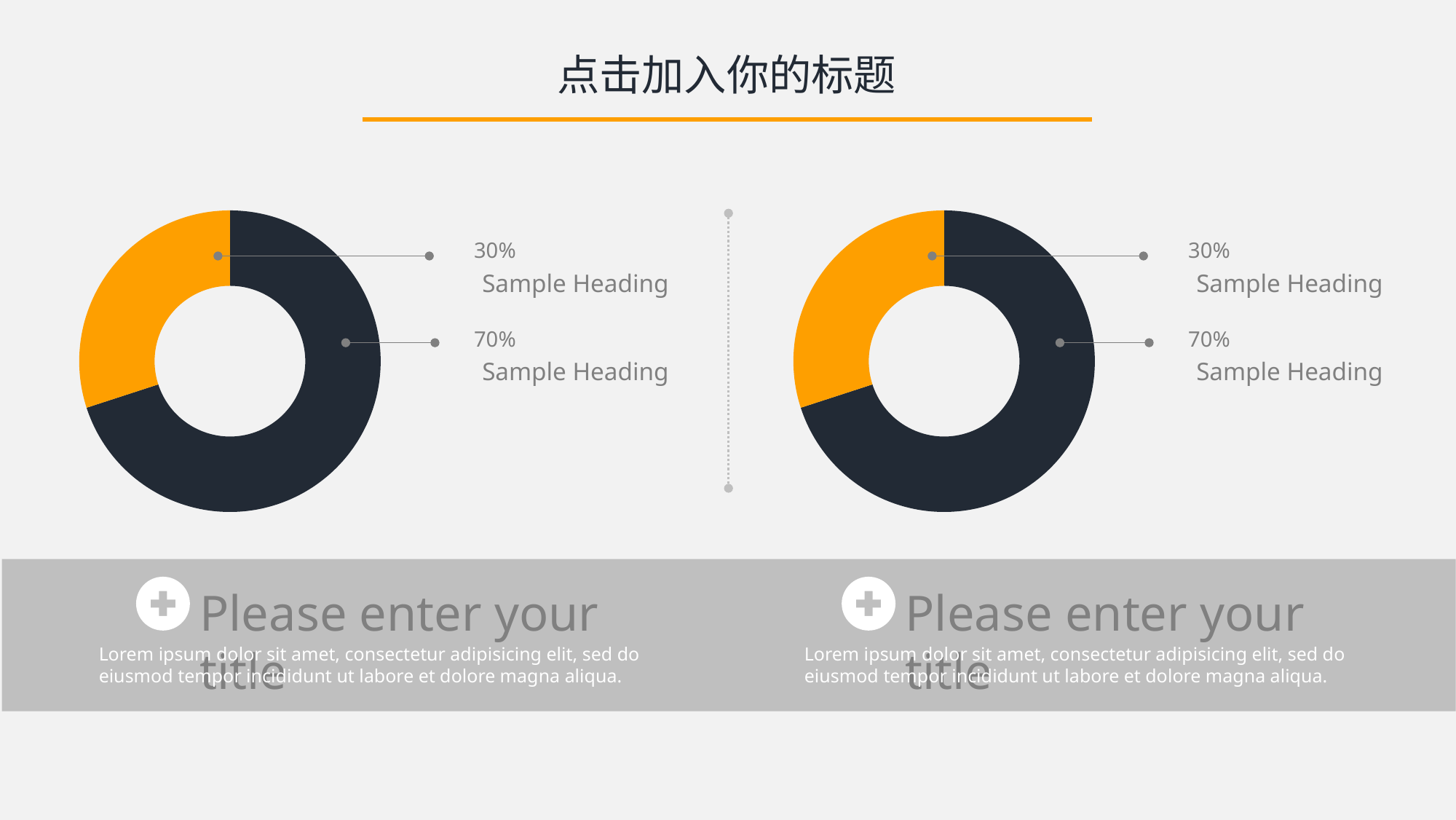
How many donut charts are shown on the slide? 2 What kind of chart is the left chart on the slide? Donut chart What kind of chart is the right chart on the slide? Donut chart In the left chart, what percentage does the dark slice represent? 70% In the right chart, what percentage does the dark slice represent? 70% In the right chart, which slice is the smallest? The orange slice (30%) How many slices does the left chart have? 2 In the right chart, what percentage does the orange slice represent? 30% In the right chart, is the dark slice larger or smaller than the orange slice? Larger In the left chart, what percentage does the orange slice represent? 30% In the left chart, what is the difference between the dark slice and the orange slice? 40% In the left chart, which slice is the largest? The dark slice (70%)